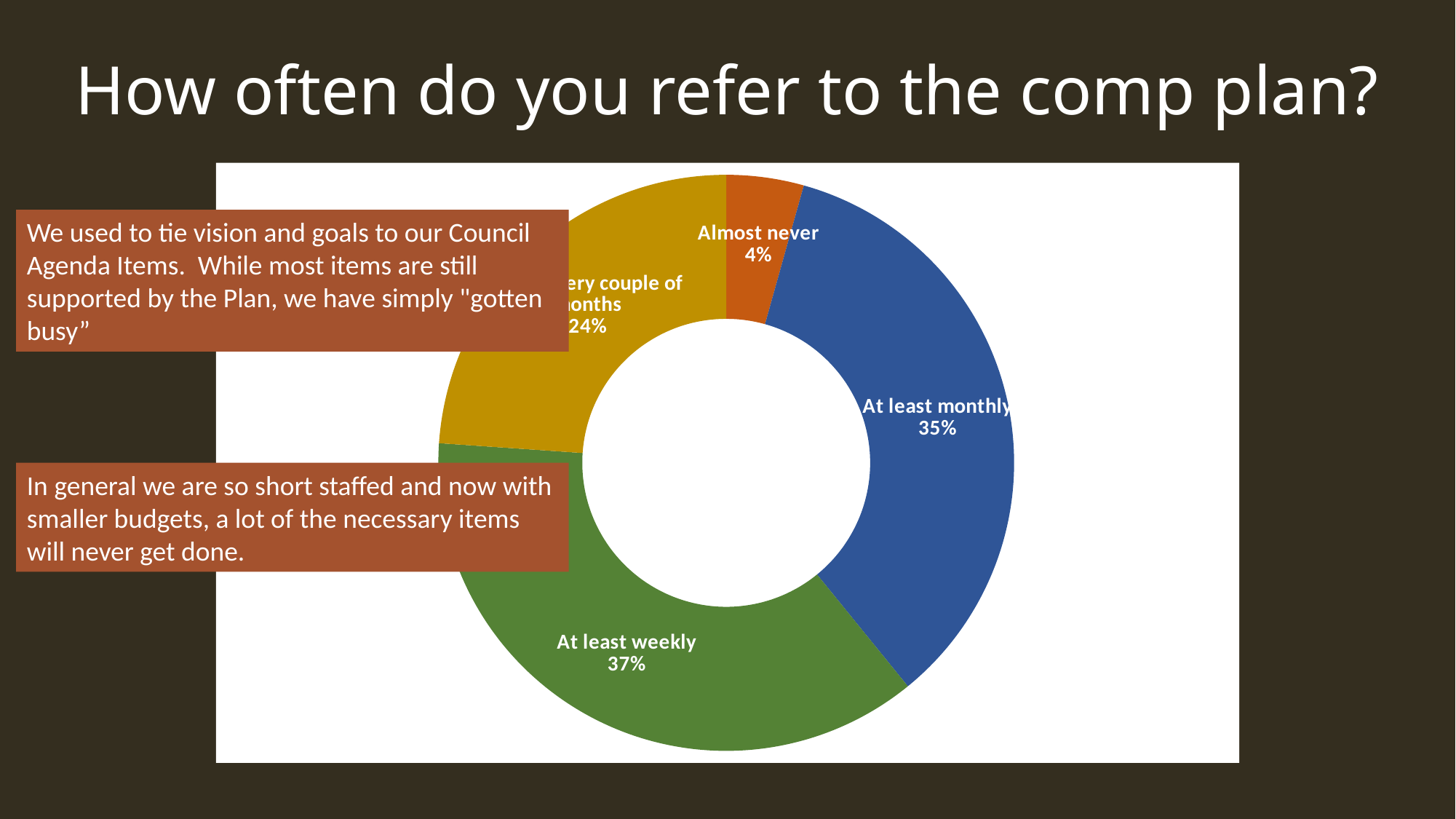
How many percentage points higher is 'At least weekly' than 'At least monthly'? 2 percentage points What percentage of respondents almost never refer to the comp plan? 4% What kind of chart is shown on the slide? doughnut chart Which response category has the smallest share of the chart? Almost never How many response categories are shown in the chart? 4 What colour is the 'At least monthly' slice? blue What percentage is shown for the 'Every couple of months' slice? 24% What is the title of the slide containing the chart? How often do you refer to the comp plan? What percentage of respondents refer to the comp plan at least monthly? 35% What percentage of respondents refer to the comp plan at least weekly? 37% Which response category has the largest share of the chart? At least weekly Which is larger: the share for 'At least monthly' or the share for 'Almost never'? At least monthly